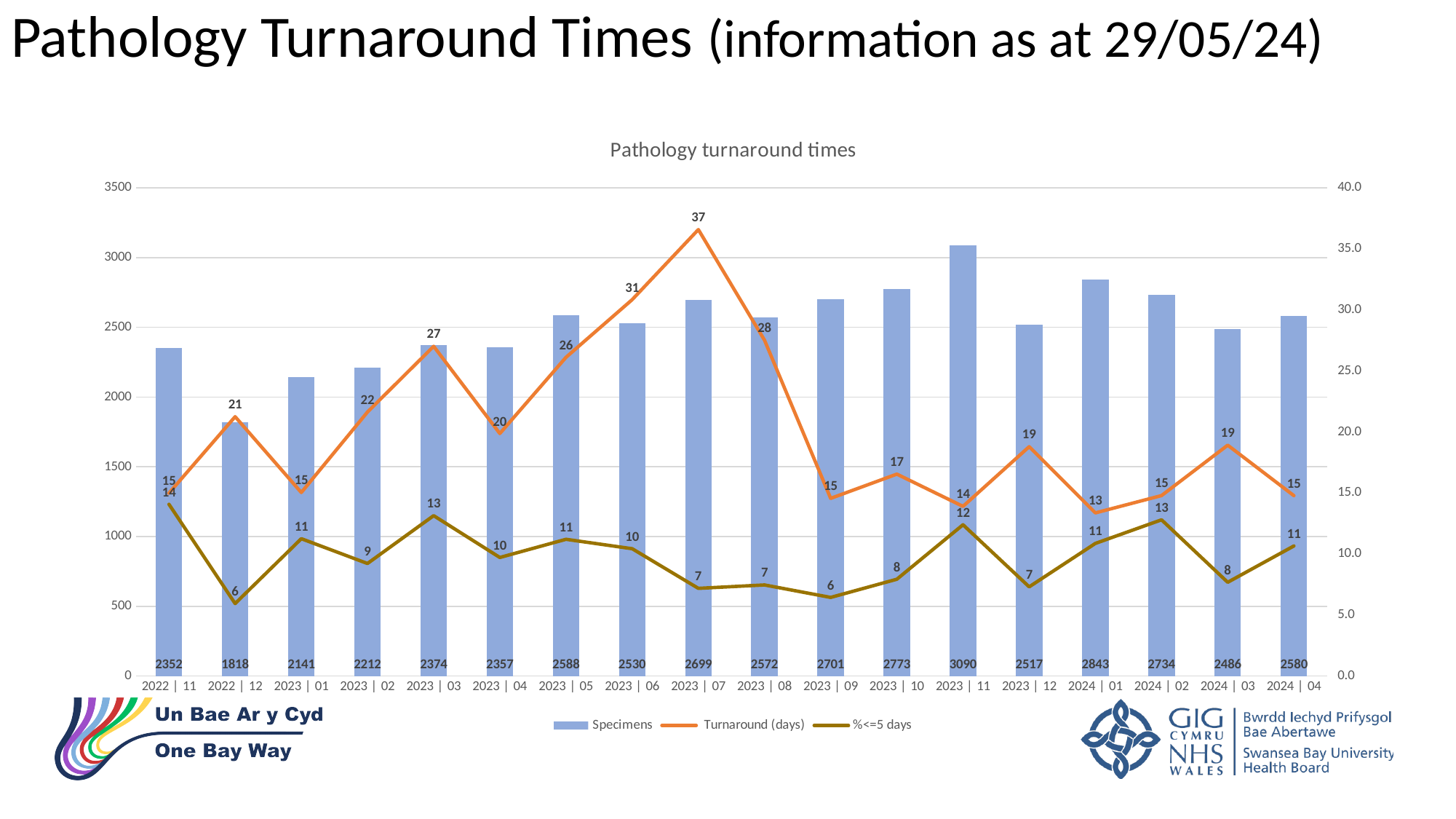
How many specimens were recorded for 2023 | 11? 3090 What kind of chart is used to show the Specimens series? Bar chart In which month does the Turnaround (days) series reach its highest value? 2023 | 07 How many series does the legend list? 3 How many months are shown on the x axis? 18 What is the %<=5 days value for 2024 | 02? 13 Which month has the lowest number of specimens? 2022 | 12 By how much did Turnaround (days) fall from 2023 | 07 to 2023 | 08? 9 What is the Turnaround (days) value for 2023 | 07? 37 Which month has the highest number of specimens? 2023 | 11 Which month has the higher Turnaround (days) value, 2023 | 05 or 2023 | 06? 2023 | 06 What is the difference in specimens between 2023 | 11 and 2022 | 12? 1272